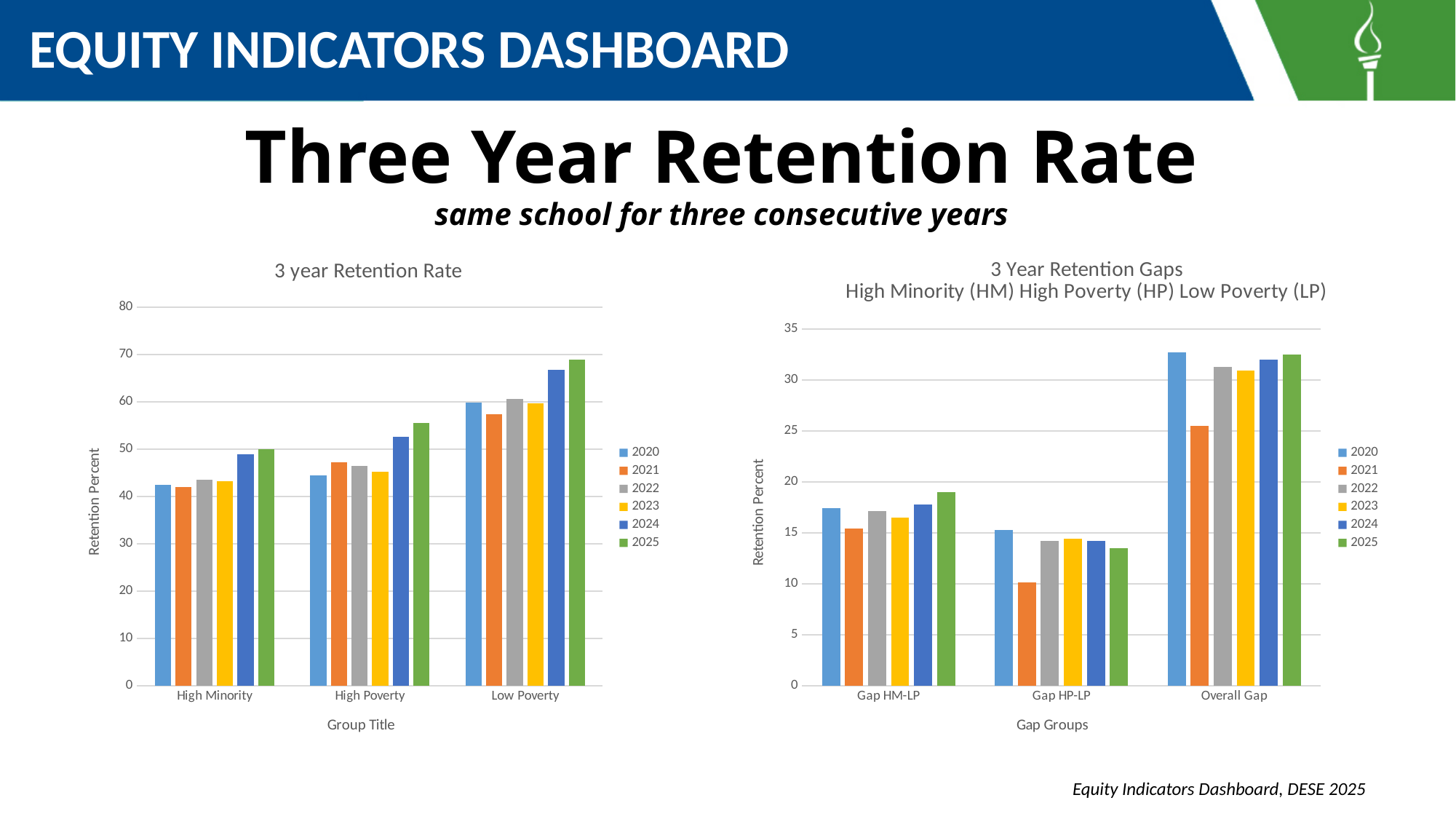
In the '3 Year Retention Gaps' chart on the right, is the 2021 value for Gap HP-LP greater or less than 15? less In the '3 year Retention Rate' chart on the left, is the 2020 value for High Minority greater or less than 50? less In the '3 year Retention Rate' chart on the left, do the 2025 values rise or fall from High Minority to Low Poverty? rise In the '3 year Retention Rate' chart on the left, how many series does the legend list? 6 In the '3 Year Retention Gaps' chart on the right, which year has the lowest value for Gap HP-LP? 2021 In the '3 year Retention Rate' chart on the left, which year has the highest value for Low Poverty? 2025 In the '3 Year Retention Gaps' chart on the right, is the 2020 value for Overall Gap greater or less than 30? greater In the '3 year Retention Rate' chart on the left, what kind of chart is shown? bar chart In the '3 year Retention Rate' chart on the left, which group has the larger 2025 value, High Minority or Low Poverty? Low Poverty In the '3 Year Retention Gaps' chart on the right, what is the title of the x axis? Gap Groups In the '3 year Retention Rate' chart on the left, how many groups are shown on the x axis? 3